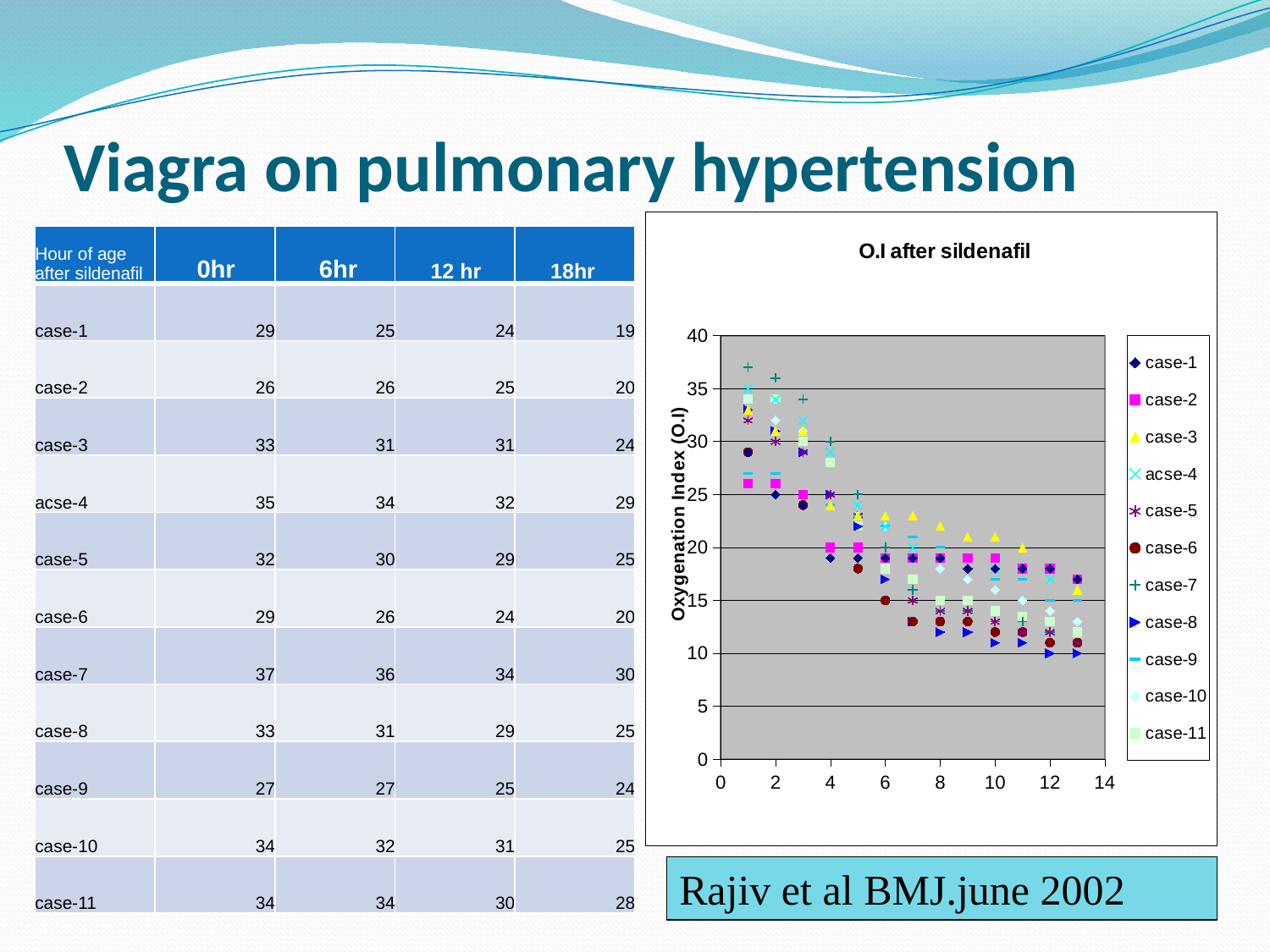
Is the value for case-3 at x = 13 greater or less than 20? less Which series has the highest plotted value at x = 1? case-7 What is the label on the chart's vertical axis? Oxygenation Index (O.I) Do the plotted values generally rise or fall as the x axis increases? fall What is the title of the chart? O.I after sildenafil What kind of chart is shown on the slide? scatter chart How many series does the chart legend list? 11 Is the value for case-7 at x = 1 greater or less than 35? greater At x = 1, which series has the higher value, case-7 or case-6? case-7 Is the value for case-6 at x = 6 greater or less than 20? less